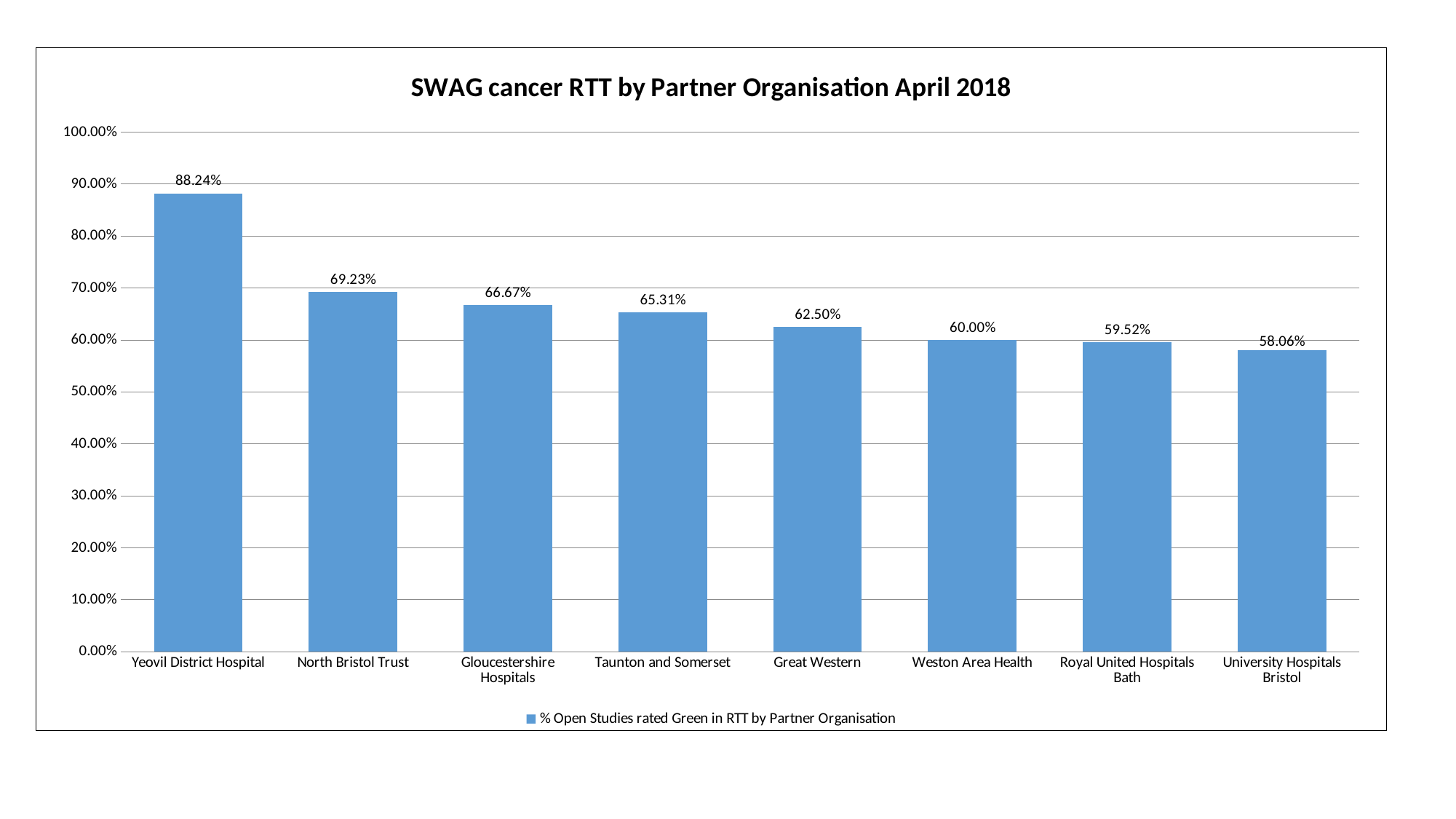
Which is larger, the value for Gloucestershire Hospitals or the value for Weston Area Health? Gloucestershire Hospitals What is the value for Yeovil District Hospital? 88.24% Is the value for Taunton and Somerset greater or less than 70.00%? less Which partner organisation has the lowest value? University Hospitals Bristol Which partner organisation has the highest value? Yeovil District Hospital What is the title of the chart? SWAG cancer RTT by Partner Organisation April 2018 How many partner organisations are shown on the chart? 8 What is the difference between the values for Yeovil District Hospital and North Bristol Trust? 19.01% What kind of chart is shown on the slide? Bar chart What is the value for Great Western? 62.50% How many series does the legend list? 1 What is the value for Royal United Hospitals Bath? 59.52%